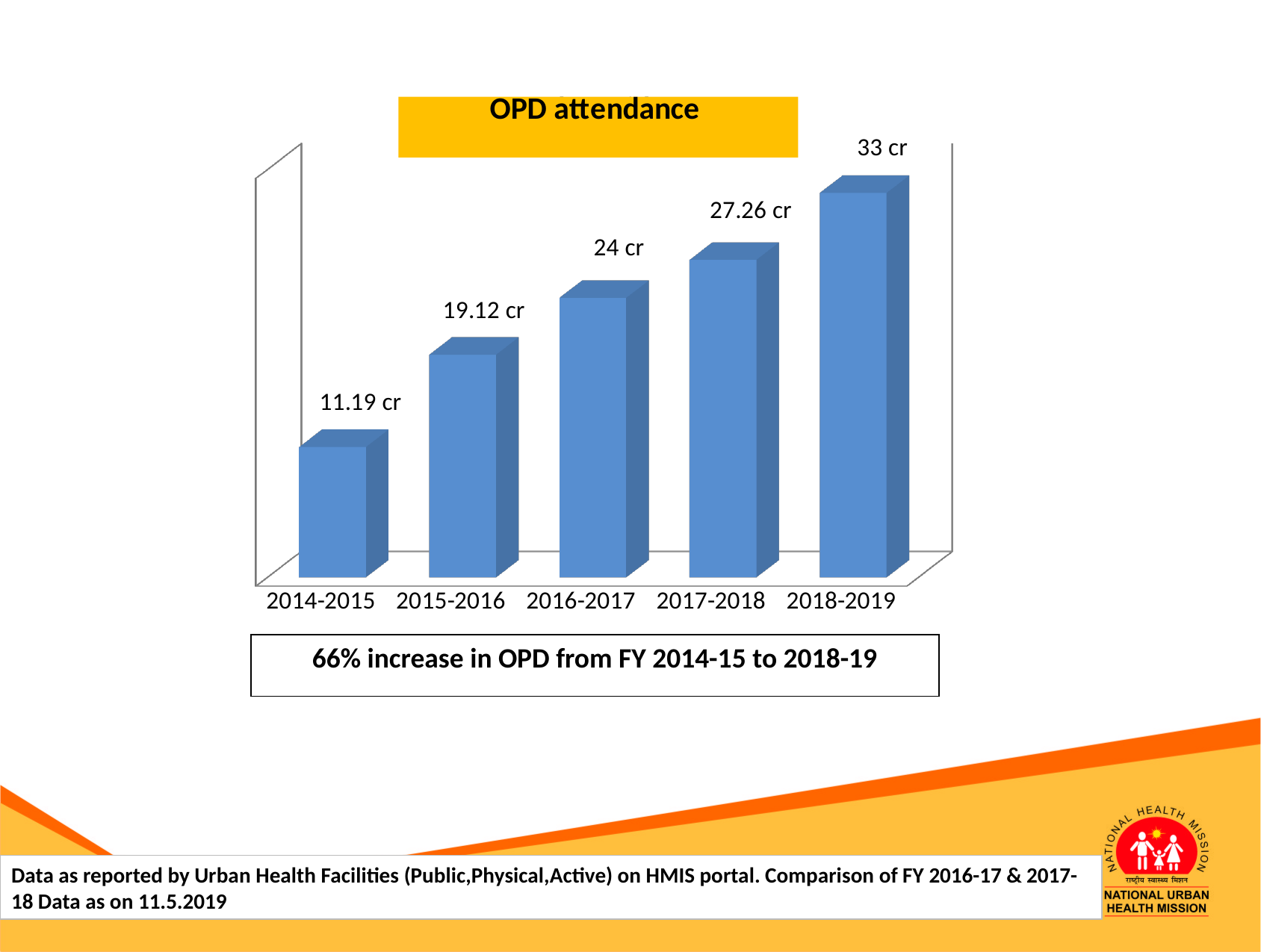
What is the title of the chart? OPD attendance What is the difference in OPD attendance between 2017-2018 and 2016-2017? 3.26 cr How many years are shown on the chart? 5 Which year has the lowest OPD attendance? 2014-2015 Does OPD attendance rise or fall from 2014-2015 to 2018-2019? Rise Which year has the highest OPD attendance? 2018-2019 Which is larger, the OPD attendance for 2015-2016 or for 2016-2017? 2016-2017 What kind of chart is shown on the slide? Bar chart What is the OPD attendance value for 2017-2018? 27.26 cr What is the difference in OPD attendance between 2018-2019 and 2014-2015? 21.81 cr What is the OPD attendance value for 2014-2015? 11.19 cr What is the OPD attendance value for 2016-2017? 24 cr